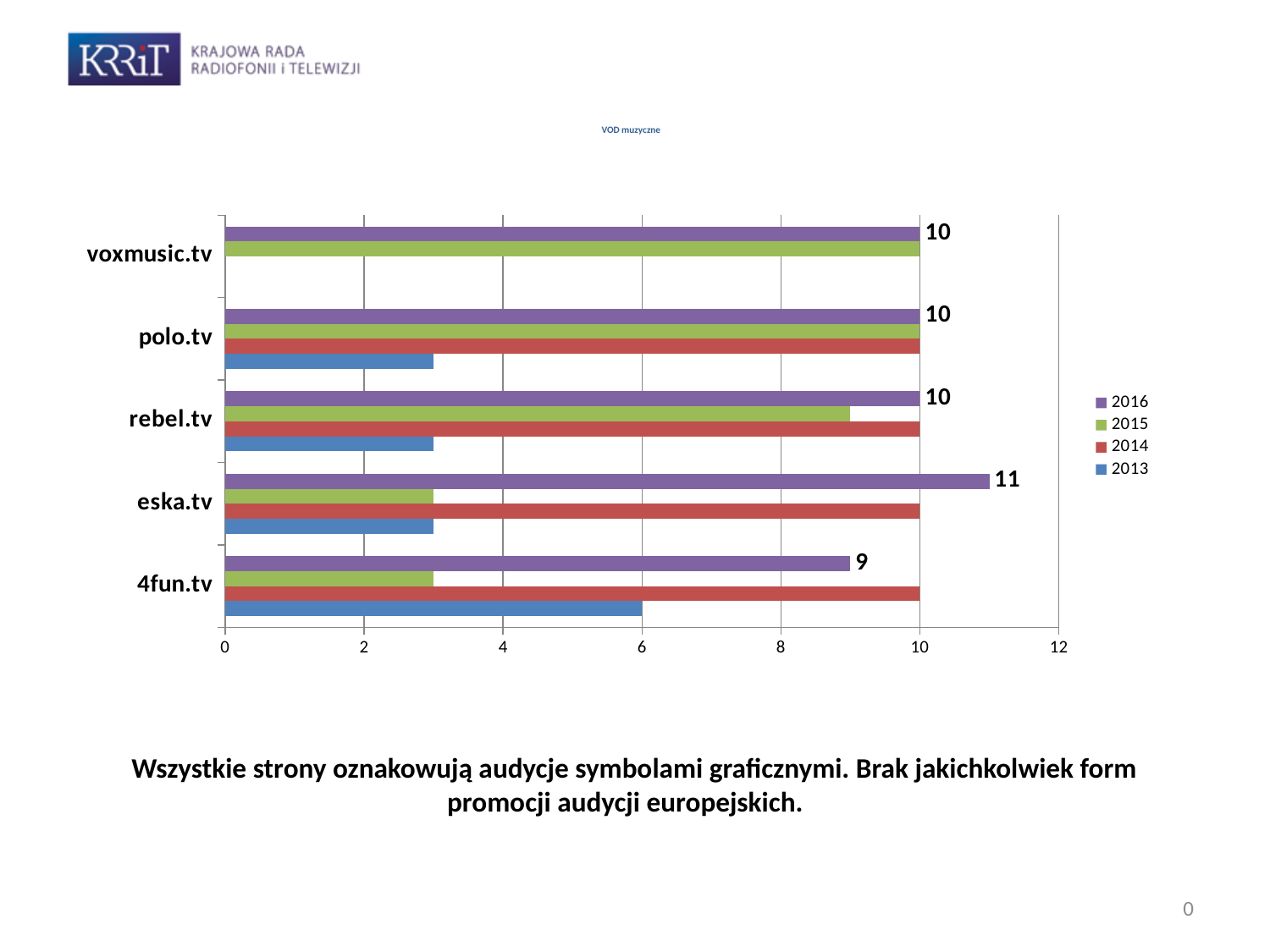
What is the 2013 value for 4fun.tv? 6 How many series does the legend list? 4 Is the 2015 value for eska.tv greater or less than 4? less What is the 2016 value for eska.tv? 11 What kind of chart is shown on the slide? bar chart Is the 2013 value for polo.tv greater or less than 4? less Which has the larger 2016 value, eska.tv or polo.tv? eska.tv How many categories are shown on the chart? 5 Which category has the lowest 2016 value? 4fun.tv What is the difference between the 2016 values for eska.tv and 4fun.tv? 2 Which category has the highest 2016 value? eska.tv What is the 2016 value for 4fun.tv? 9